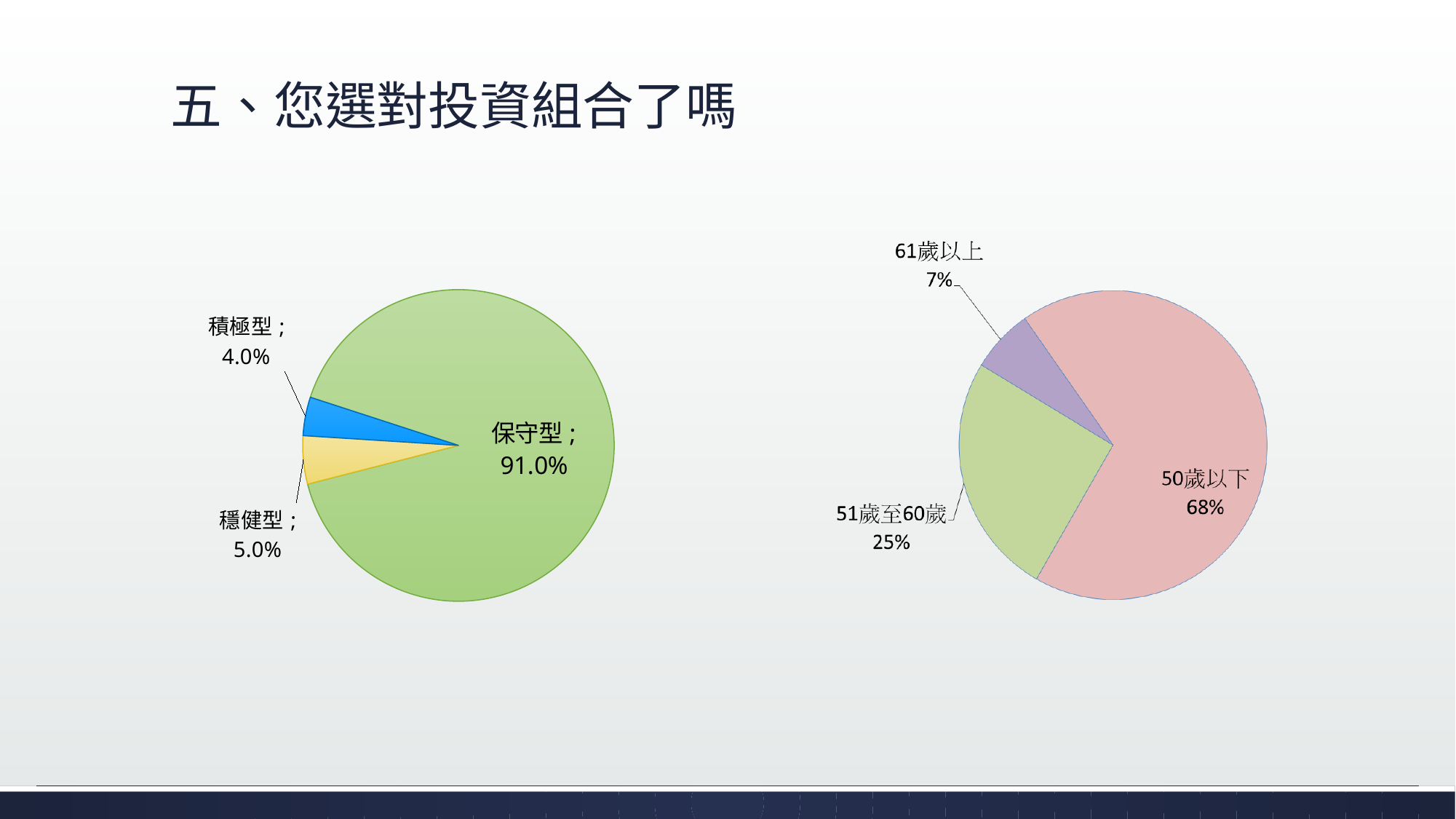
In the left pie chart, what is the value for 積極型? 4.0% In the right pie chart, what is the difference between 50歲以下 and 51歲至60歲? 43% In the right pie chart, which is larger, 51歲至60歲 or 61歲以上? 51歲至60歲 In the right pie chart, what is the value for 61歲以上? 7% In the right pie chart, which category has the largest share? 50歲以下 In the right pie chart, what is the value for 51歲至60歲? 25% In the left pie chart, what is the value for 保守型? 91.0% In the left pie chart, which category has the smallest share? 積極型 What kind of chart is the chart on the left? pie chart In the left pie chart, what colour is the 保守型 slice? green In the left pie chart, what is the difference between 穩健型 and 積極型? 1.0% In the left pie chart, how many slices are there? 3